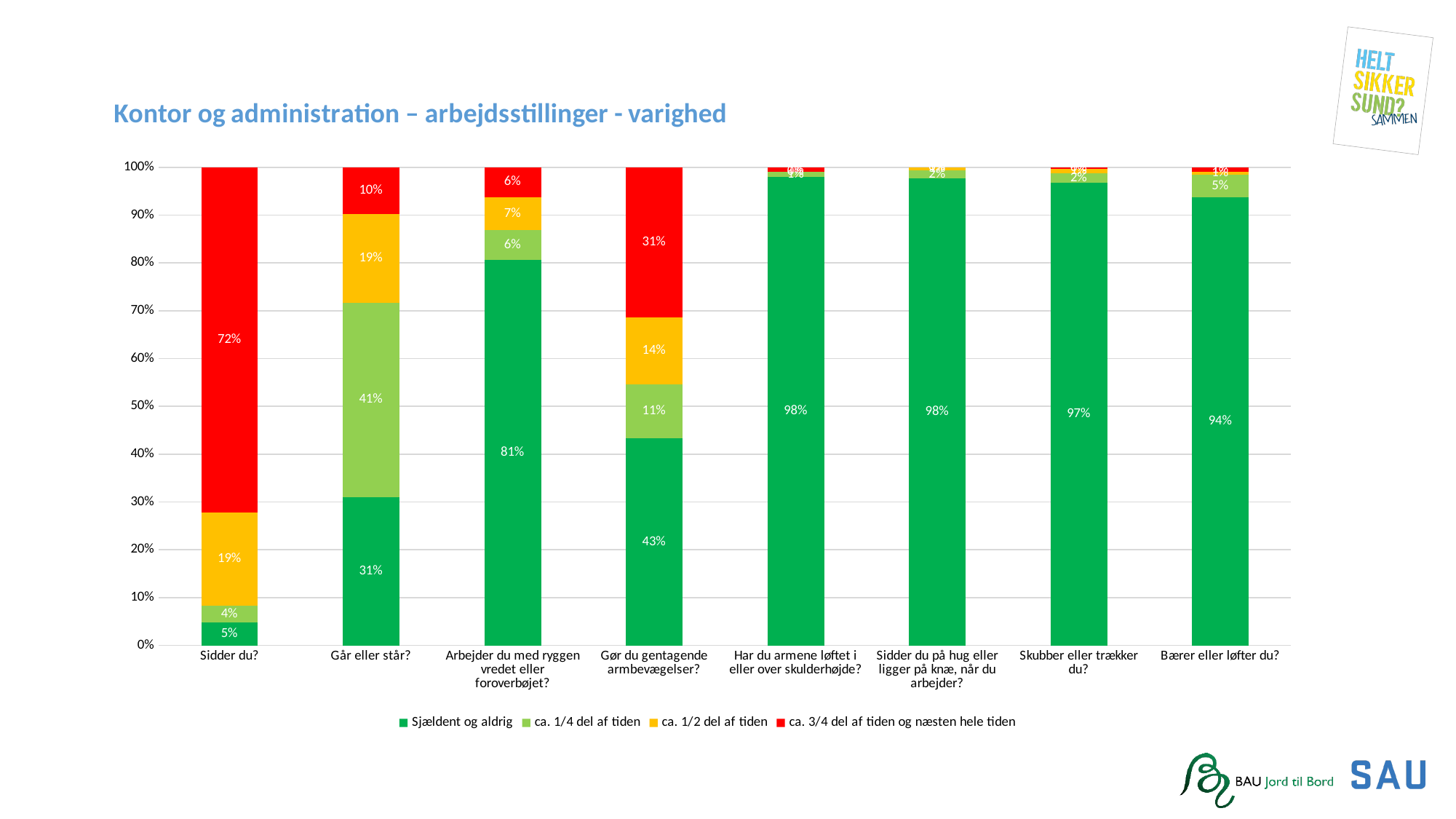
Which category has the highest value for 'Sjældent og aldrig'? Har du armene løftet i eller over skulderhøjde? and Sidder du på hug eller ligger på knæ, når du arbejder? (98%) What kind of chart is shown on the slide? Stacked bar chart What is the value of 'ca. 1/4 del af tiden' for 'Går eller står?'? 41% What is the title of the chart? Kontor og administration – arbejdsstillinger - varighed What is the difference between the 'ca. 3/4 del af tiden og næsten hele tiden' values for 'Sidder du?' and 'Gør du gentagende armbevægelser?'? 41 percentage points How many categories (questions) are shown along the x axis? 8 What is the value of 'ca. 3/4 del af tiden og næsten hele tiden' for 'Sidder du?'? 72% What is the value of 'ca. 1/2 del af tiden' for 'Gør du gentagende armbevægelser?'? 14% Which is larger: the 'ca. 1/2 del af tiden' value for 'Går eller står?' or for 'Arbejder du med ryggen vredet eller foroverbøjet?'? Går eller står? What is the value of 'Sjældent og aldrig' for 'Arbejder du med ryggen vredet eller foroverbøjet?'? 81% Which category has the lowest value for 'Sjældent og aldrig'? Sidder du? How many series does the legend list? 4